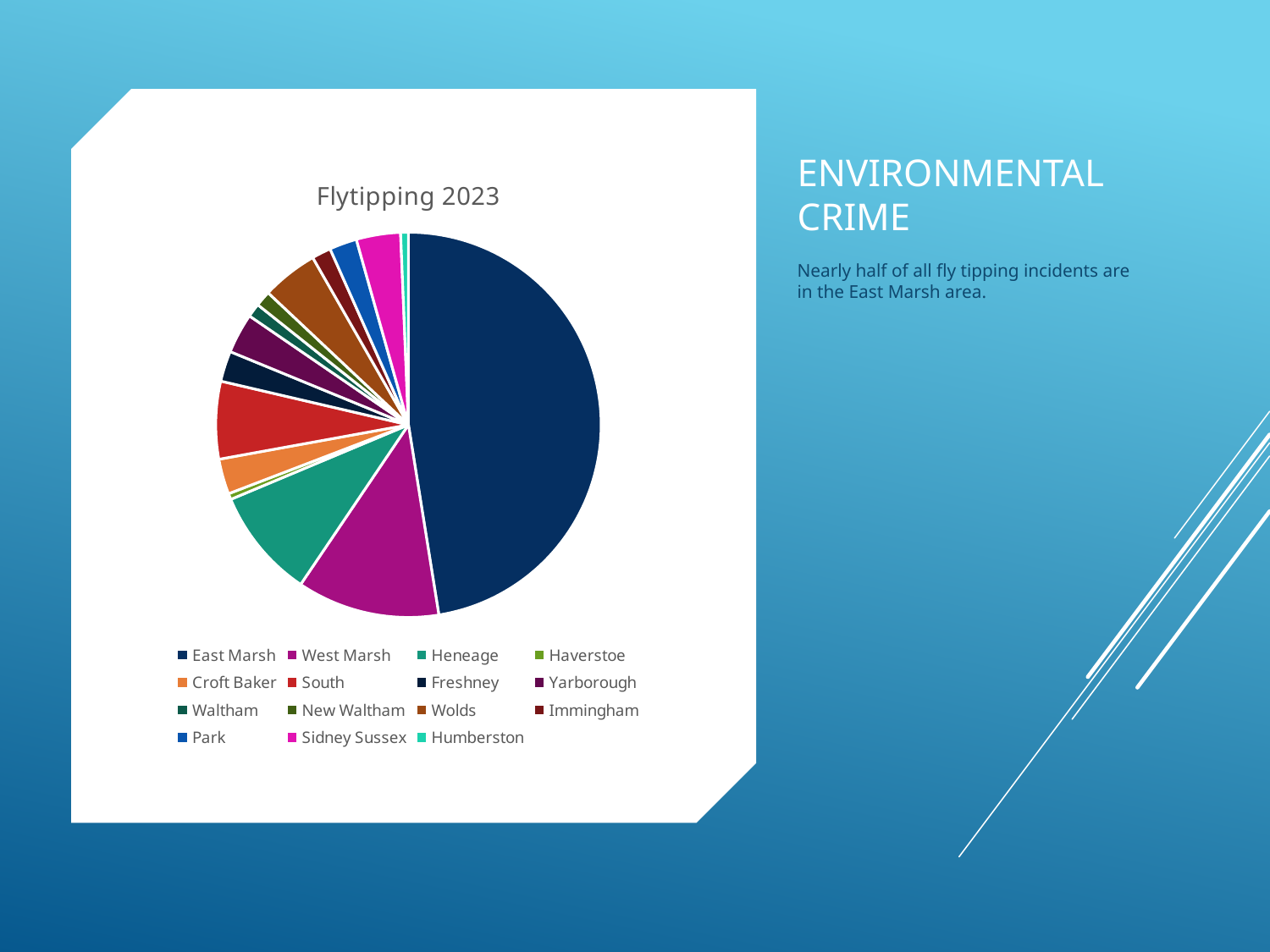
Which slice is larger, East Marsh or Heneage? East Marsh Which slice is larger, Wolds or Immingham? Wolds Which slice is larger, Yarborough or New Waltham? Yarborough What kind of chart is shown on the slide? Pie chart Which category has the largest slice of the pie? East Marsh Which category is the first entry listed in the legend? East Marsh How many categories does the pie chart's legend list? 15 What is the title of the chart? Flytipping 2023